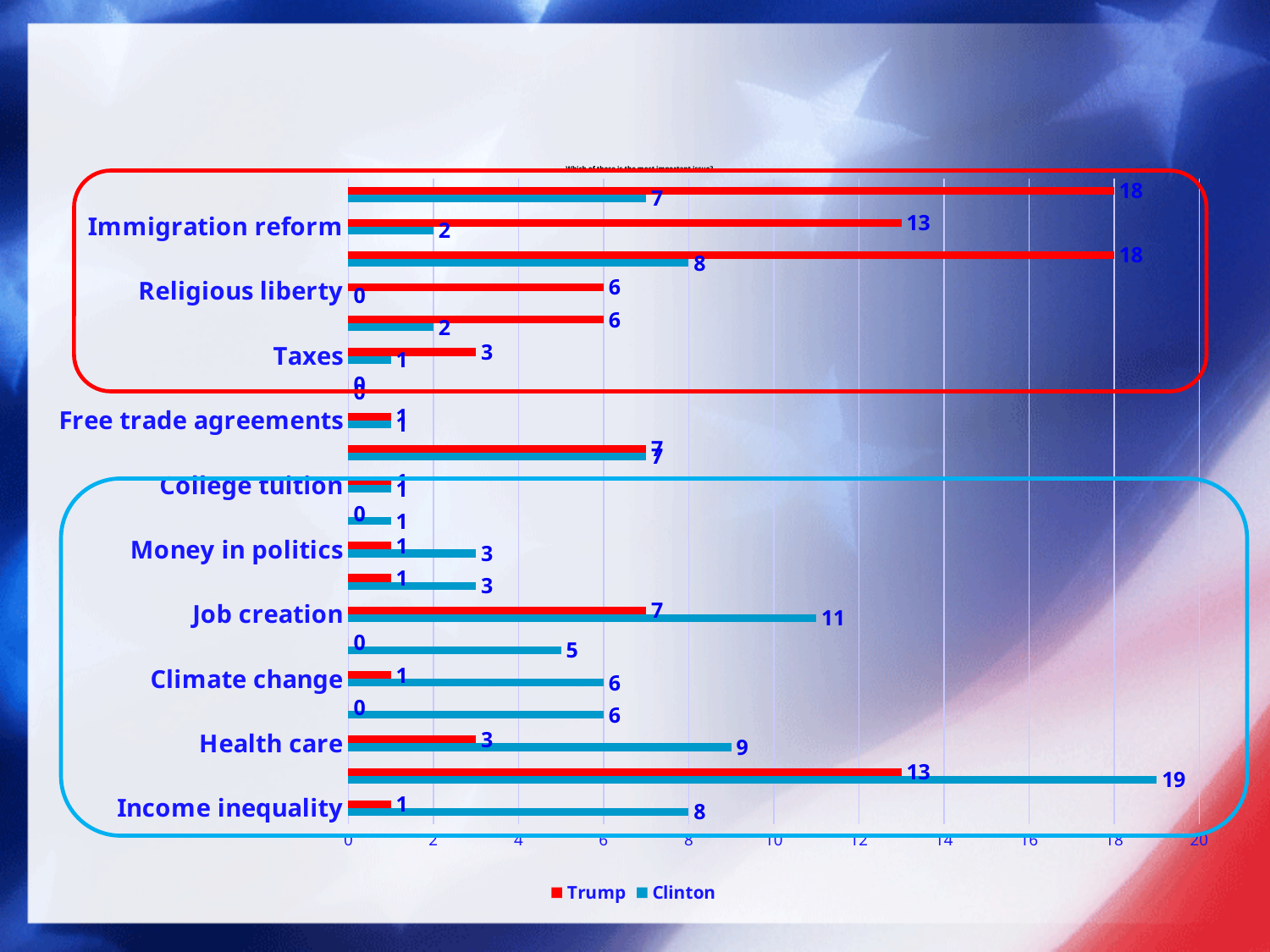
For Immigration reform, which series has the larger value, Trump or Clinton? Trump What is the Trump value for Immigration reform? 13 What kind of chart is shown on the slide? Bar chart For Job creation, what is the difference between the Clinton value and the Trump value? 4 What is the Trump value for Taxes? 3 For Health care, what is the difference between the Clinton value and the Trump value? 6 What is the Clinton value for Health care? 9 How many series does the legend list? 2 What is the Trump value for Religious liberty? 6 What is the Clinton value for Job creation? 11 For Climate change, which series has the larger value, Trump or Clinton? Clinton What is the Clinton value for Income inequality? 8